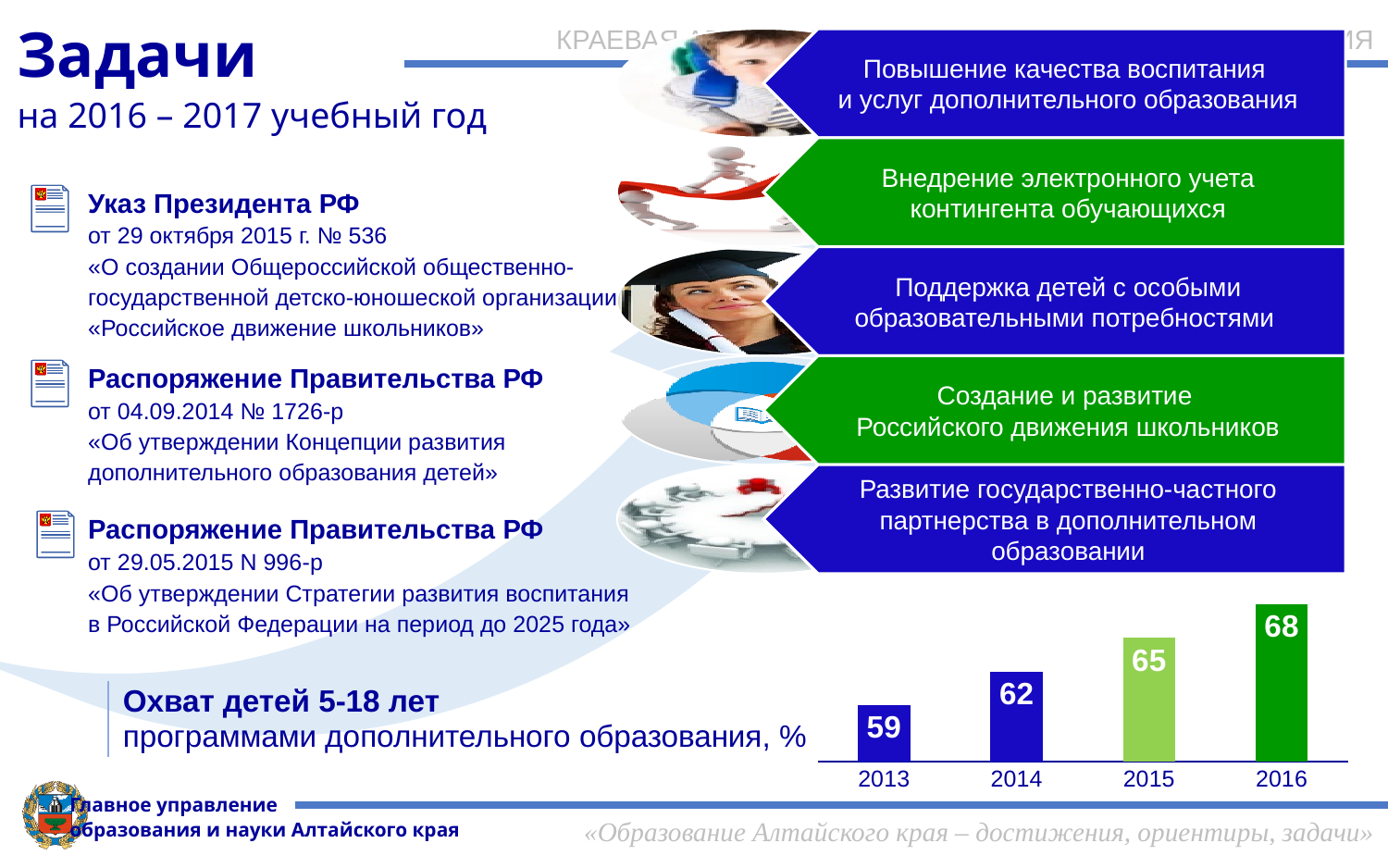
What is the value for 2015 in the bar chart? 65 What is the value for 2013 in the bar chart? 59 What is the value for 2016 in the bar chart? 68 What unit is the coverage of children aged 5-18 in additional education programmes expressed in, according to the chart heading? % Which year has the highest value in the bar chart? 2016 What is the difference between the values for 2015 and 2014? 3 Do the values in the bar chart rise or fall from 2013 to 2016? rise How many years are shown in the bar chart? 4 Which year has the lowest value in the bar chart? 2013 What is the difference between the values for 2016 and 2013? 9 Which is larger, the value for 2014 or the value for 2015? 2015 What kind of chart is shown at the bottom right of the slide? bar chart